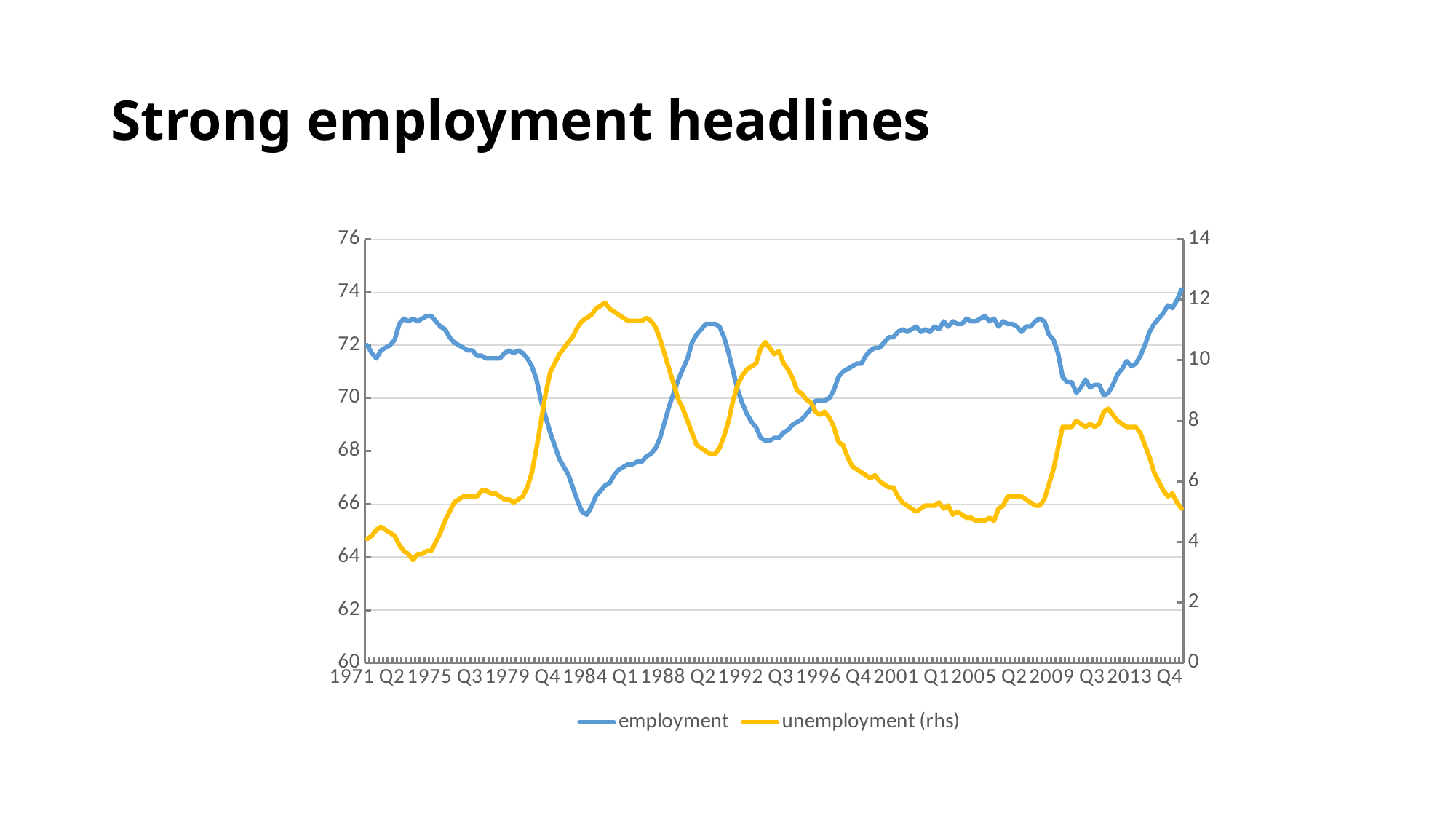
Is the employment value at 1992 Q3 greater or less than 70? less Is the employment value at 1984 Q1 greater or less than 68? less Which series is plotted against the right-hand axis, according to the legend? unemployment (rhs) How many series does the legend list? 2 Does the employment line rise or fall between 2009 Q3 and 2013 Q4? rise What kind of chart is shown on the slide? line chart Is the unemployment (rhs) value at 1992 Q3 greater or less than 8? greater What is the title of the slide containing the chart? Strong employment headlines Does the unemployment (rhs) line rise or fall between 2009 Q3 and 2013 Q4? fall